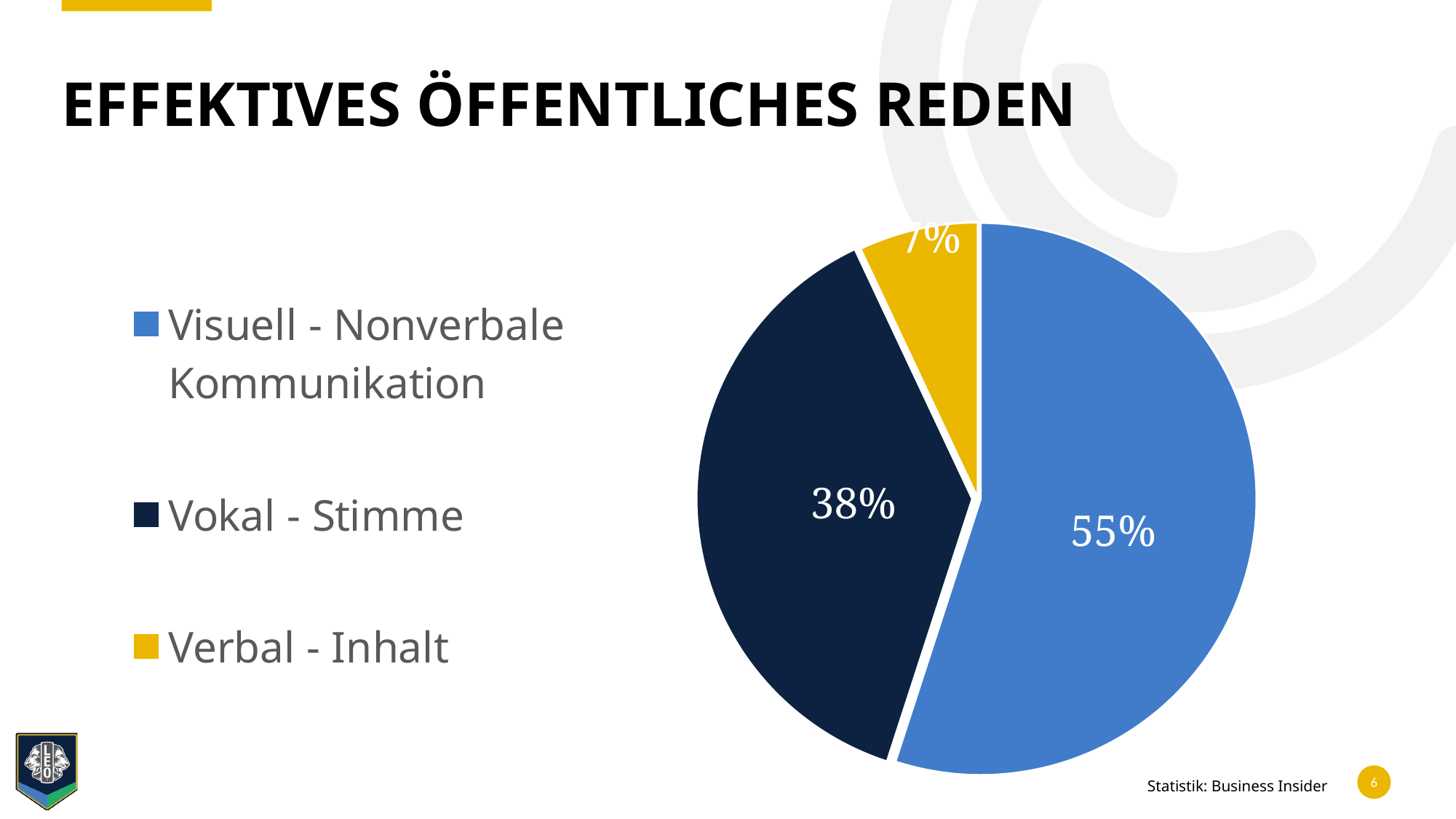
What kind of chart is shown on the slide? pie chart What is the difference in percentage points between Vokal - Stimme and Verbal - Inhalt? 31 What share of the pie does Visuell - Nonverbale Kommunikation have? 55% What share of the pie does Vokal - Stimme have? 38% Which category has the largest slice of the pie? Visuell - Nonverbale Kommunikation Which is larger, the slice for Vokal - Stimme or the slice for Verbal - Inhalt? Vokal - Stimme What is the difference in percentage points between Visuell - Nonverbale Kommunikation and Vokal - Stimme? 17 What colour is the slice for Verbal - Inhalt? yellow What is the source of the statistic cited on the slide? Business Insider Which category has the smallest slice of the pie? Verbal - Inhalt What share of the pie does Verbal - Inhalt have? 7% How many categories does the pie chart have? 3